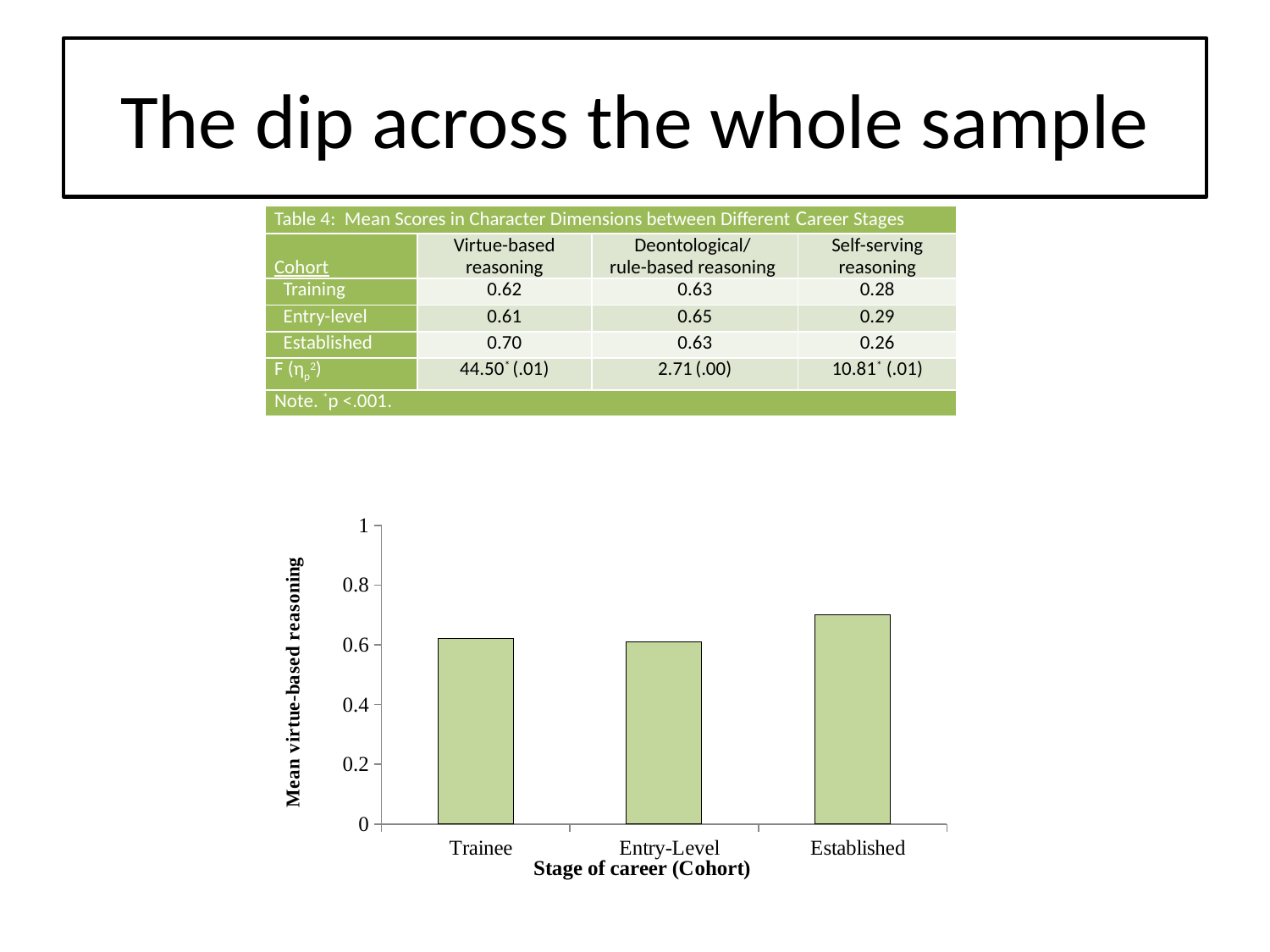
Which is larger in the chart, the bar for Established or the bar for Trainee? Established What is the title of the horizontal axis of the chart? Stage of career (Cohort) Which is larger in the chart, the bar for Established or the bar for Entry-Level? Established Is the value for Established greater or less than 0.6? greater Does the value rise or fall from Entry-Level to Established in the chart? rise What kind of chart is shown on the slide? bar chart How many career stages (cohorts) are plotted on the x axis of the chart? 3 Which cohort has the highest mean virtue-based reasoning in the chart? Established Is the value for Trainee greater or less than 0.4? greater Is the value for Entry-Level greater or less than 0.8? less What is the title of the vertical axis of the chart? Mean virtue-based reasoning